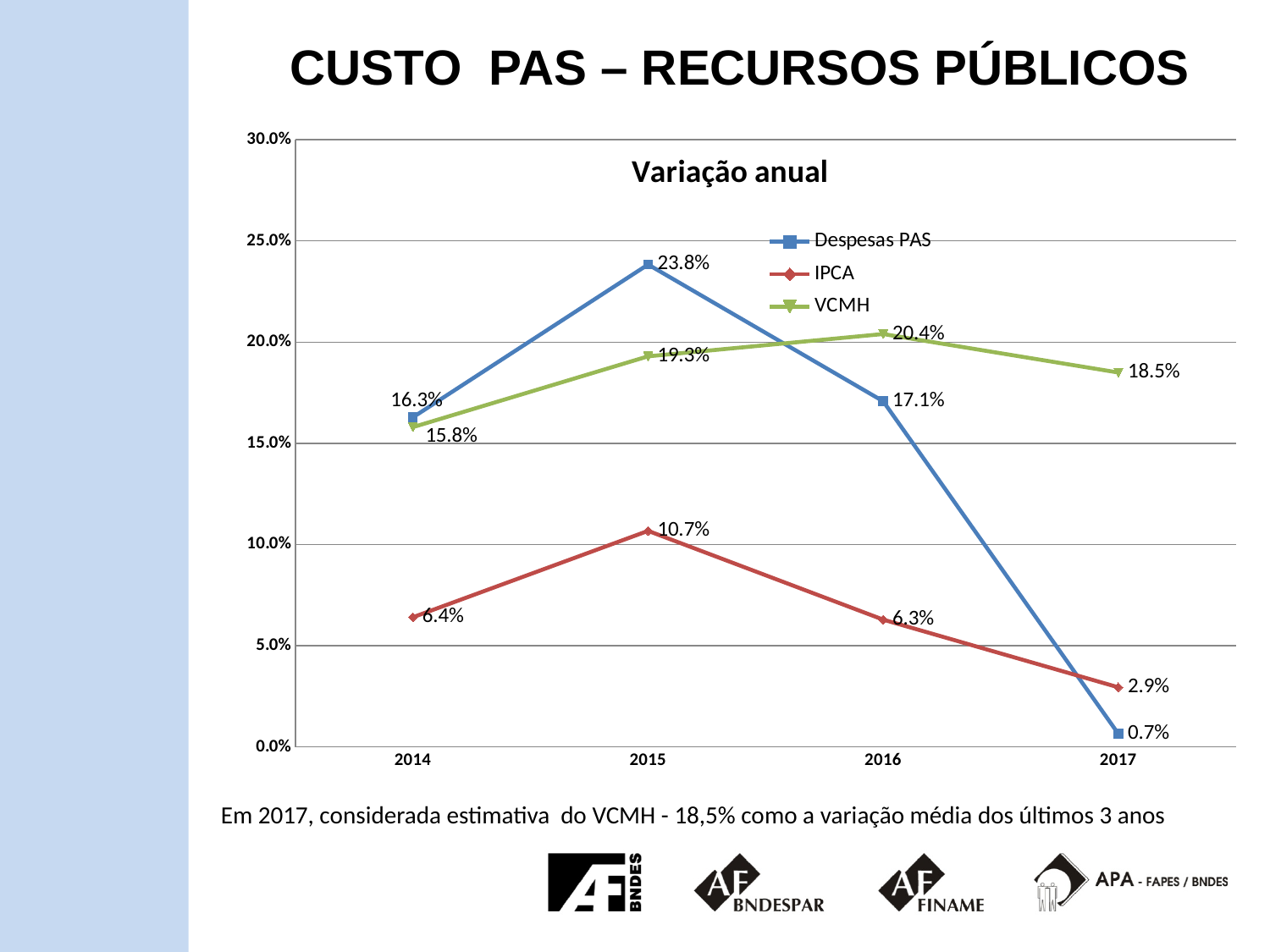
Does IPCA rise or fall from 2015 to 2017? fall How many years are plotted on the x axis? 4 What kind of chart is shown on the slide? line chart What is the difference between Despesas PAS and IPCA in 2014? 9.9% What is the value of IPCA in 2017? 2.9% What is the value of VCMH in 2016? 20.4% What is the value of Despesas PAS in 2015? 23.8% How many series does the legend list? 3 Which is larger in 2016, Despesas PAS or VCMH? VCMH What is the title of the chart? Variação anual In which year is VCMH at its highest? 2016 In which year is Despesas PAS at its lowest? 2017